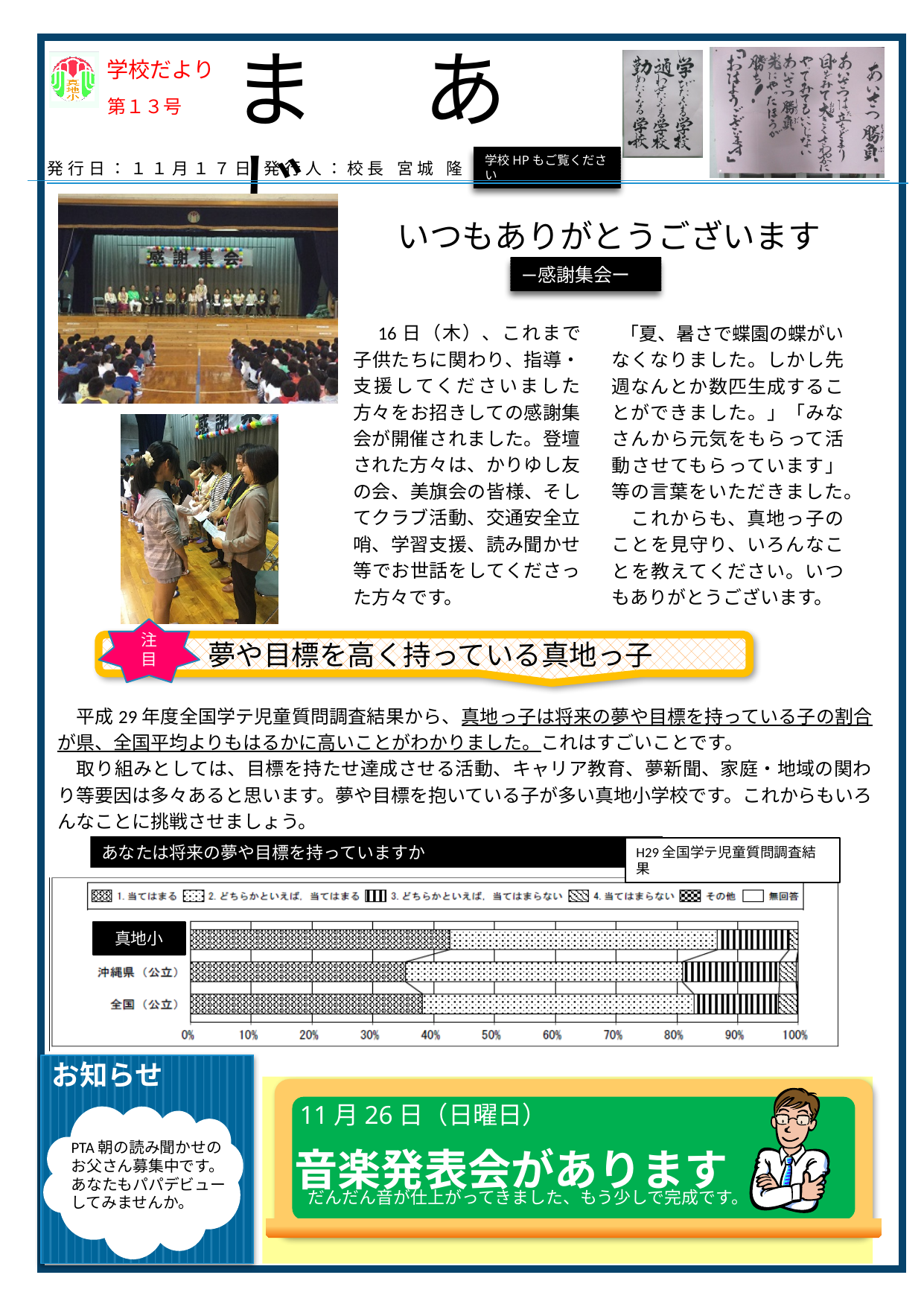
How many categories (rows) does the chart show? 3 Is the "1. 当てはまる" segment for 真地小 larger or smaller than that for 沖縄県（公立）? larger How many series does the chart's legend list? 6 Is the combined share of "1. 当てはまる" and "2. どちらかといえば、当てはまる" for 真地小 greater or less than 80%? greater Is the "1. 当てはまる" share for 全国（公立） greater or less than 30%? greater What is the title of the chart? あなたは将来の夢や目標を持っていますか What is the first entry in the chart's legend? 1. 当てはまる What kind of chart is shown on the slide? bar chart Which category has the largest "1. 当てはまる" segment? 真地小 Is the "1. 当てはまる" share for 真地小 greater or less than 40%? greater Which category has the smallest "1. 当てはまる" segment? 沖縄県（公立）